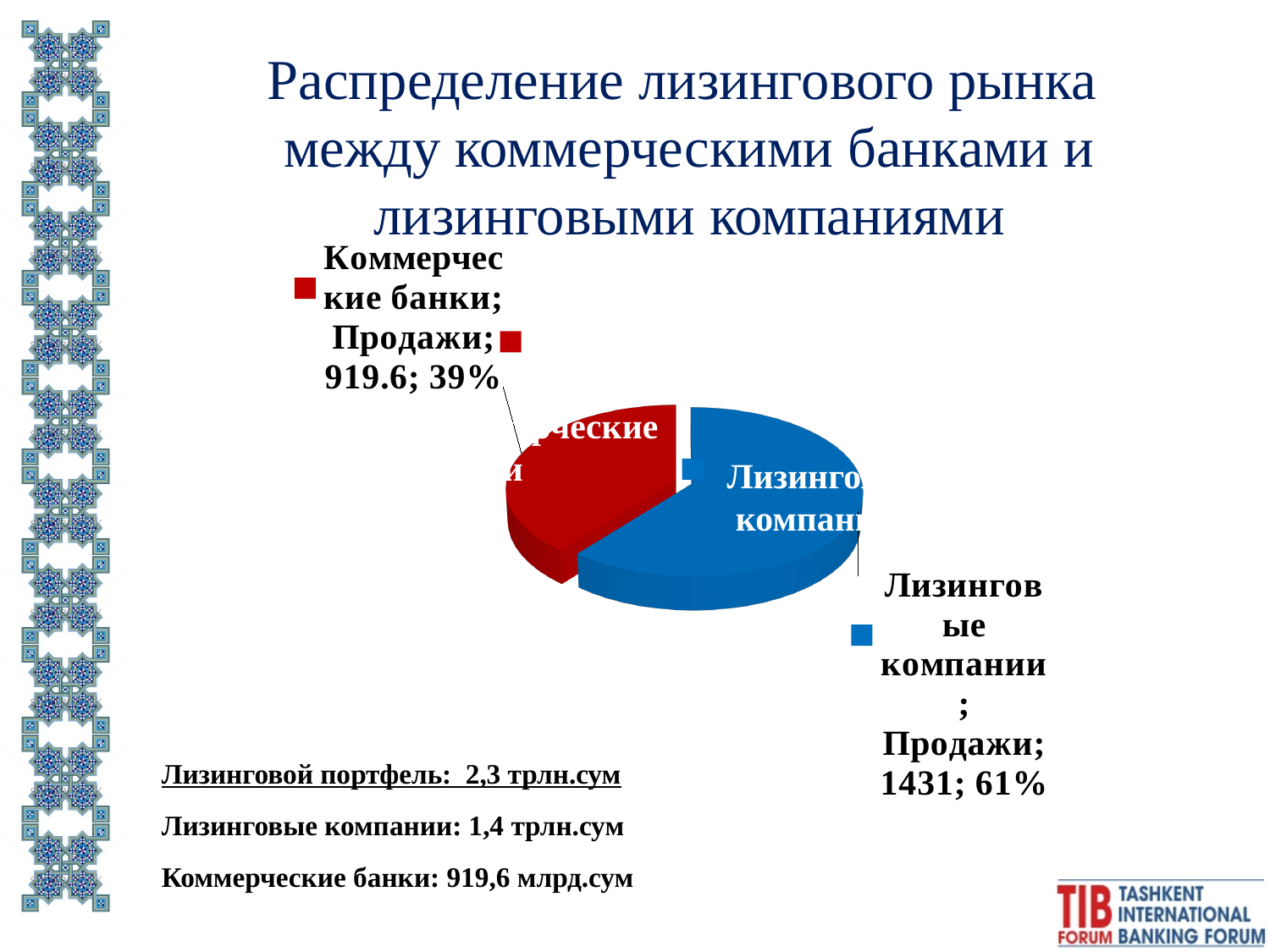
What is the value shown for Коммерческие банки in the pie chart? 919.6 What is the value shown for Лизинговые компании in the pie chart? 1431 What is the difference between the values for Лизинговые компании and Коммерческие банки? 511.4 Which is larger in the pie chart, Лизинговые компании or Коммерческие банки? Лизинговые компании What share of the pie does Лизинговые компании represent? 61% What share of the pie does Коммерческие банки represent? 39% Which slice of the pie chart is the largest? Лизинговые компании What kind of chart is shown on the slide? Pie chart How many slices does the pie chart have? 2 What colour is the Лизинговые компании slice in the pie chart? Blue Which slice of the pie chart is the smallest? Коммерческие банки What colour is the Коммерческие банки slice in the pie chart? Red